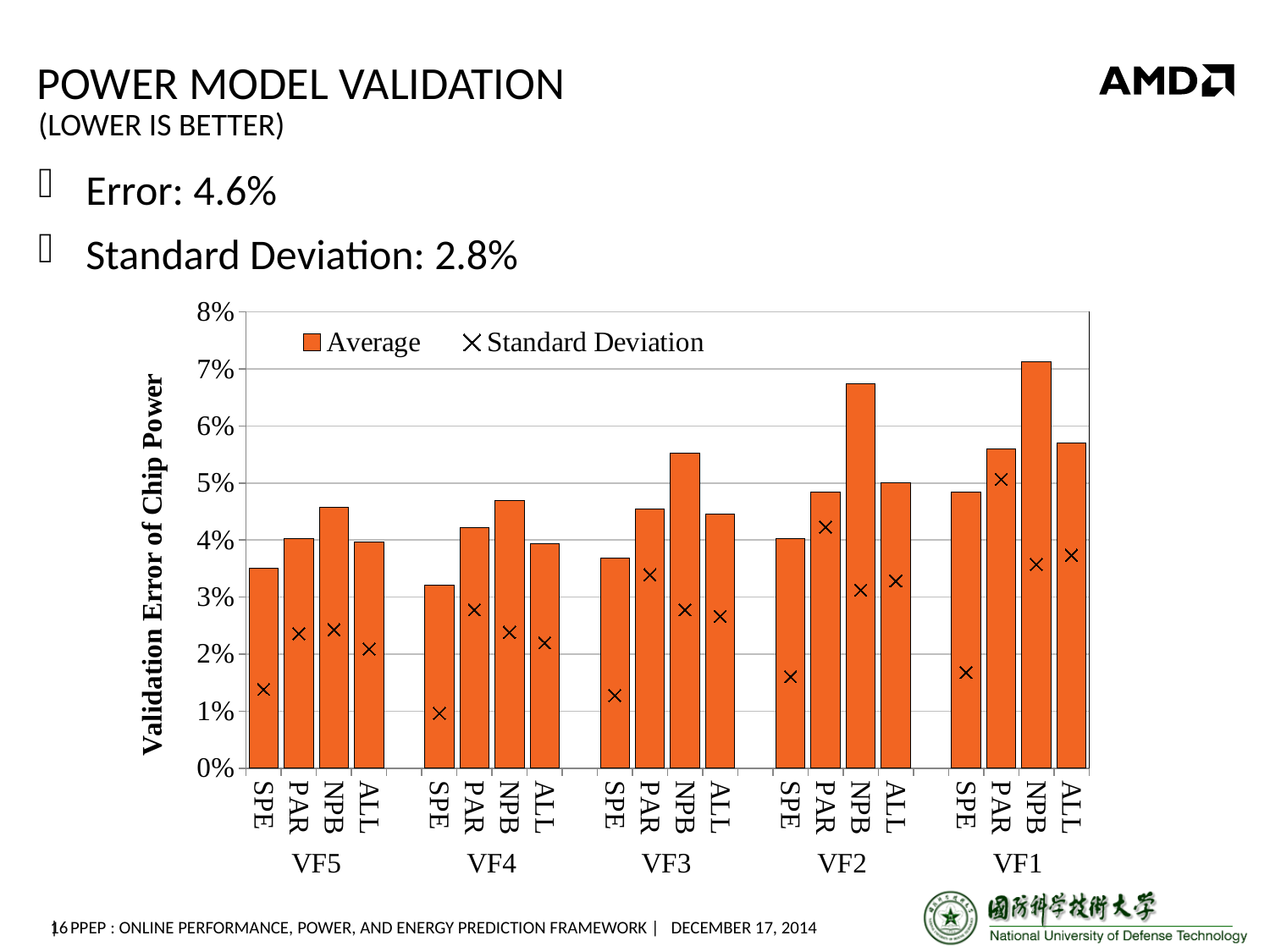
Do the Average bars for NPB rise or fall moving from VF5 to VF1 along the x axis? rise Which is larger, the Average value for NPB in VF2 or the Average value for NPB in VF3? NPB in VF2 What are the two series named in the chart legend? Average and Standard Deviation How many series does the chart legend list? 2 What is the title of the chart's vertical axis? Validation Error of Chip Power Which bar has the highest Average validation error in the chart? NPB in VF1 Is the Average value for SPE in VF4 greater or less than 4%? less How many VF groups are shown along the x axis of the chart? 5 How many Average bars are plotted in the chart in total? 20 Which bar has the lowest Average validation error in the chart? SPE in VF4 What kind of chart is shown on the slide? bar chart Is the Average value for NPB in VF2 greater or less than 6%? greater